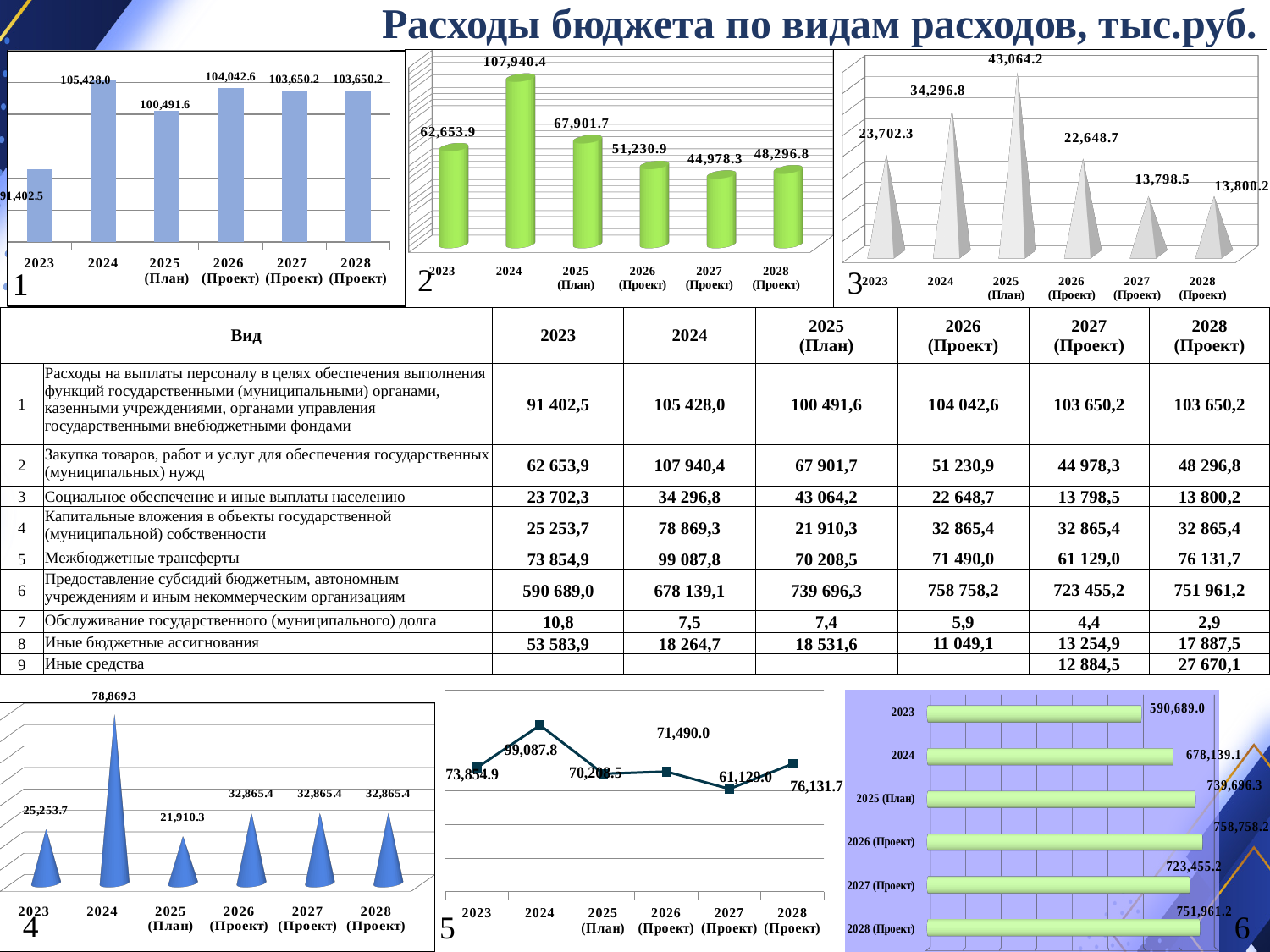
In chart 1 (top left, blue bars), which year has the lowest value? 2023 In chart 4 (bottom left, blue cones), which year has the highest value? 2024 How many categories (years) are plotted in chart 6 (bottom right, horizontal bars)? 6 In chart 5 (bottom middle, line), which is larger: the value for 2023 or the value for 2027 (Проект)? 2023 What kind of chart is chart 5 (bottom middle)? Line chart In chart 4 (bottom left, blue cones), what is the value for 2025 (План)? 21,910.3 In chart 1 (top left, blue bars), what is the value for 2024? 105,428.0 In chart 3 (top right, grey pyramids), what is the value for 2025 (План)? 43,064.2 In chart 2 (top middle, green cylinders), which year has the highest value? 2024 In chart 2 (top middle, green cylinders), what is the value for 2027 (Проект)? 44,978.3 In chart 3 (top right, grey pyramids), what is the difference between the values for 2024 and 2023? 10,594.5 In chart 6 (bottom right, horizontal bars), what is the value for 2026 (Проект)? 758,758.2